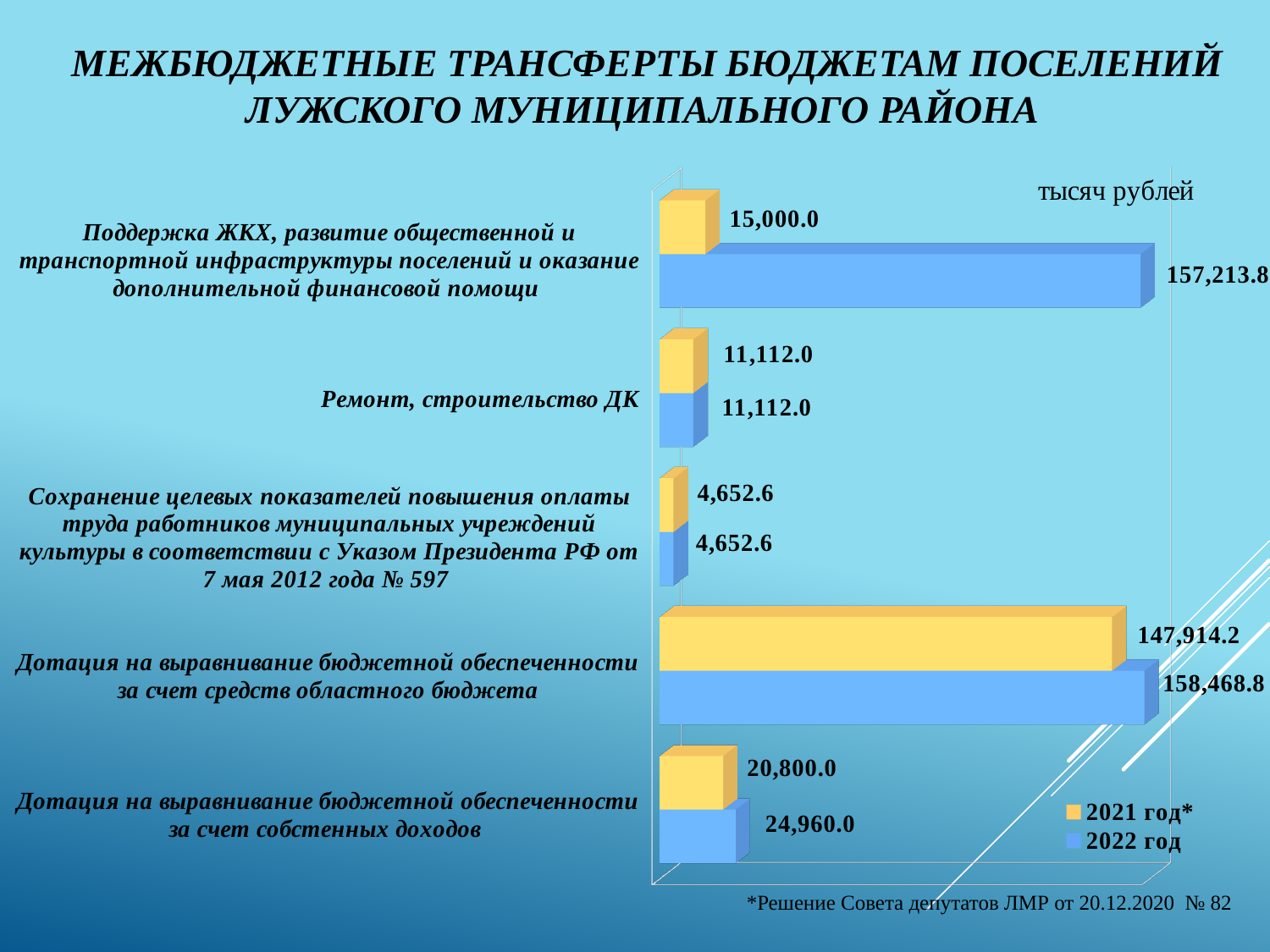
Which category has the highest 2022 год value? Дотация на выравнивание бюджетной обеспеченности за счет средств областного бюджета How many series does the legend list? 2 How many categories are shown in the chart? 5 What type of chart is shown on the slide? Bar chart What is the 2021 год* value for «Дотация на выравнивание бюджетной обеспеченности за счет средств областного бюджета»? 147,914.2 What is the 2022 год value for «Поддержка ЖКХ, развитие общественной и транспортной инфраструктуры поселений и оказание дополнительной финансовой помощи»? 157,213.8 What is the difference between the 2022 год and 2021 год* values for «Дотация на выравнивание бюджетной обеспеченности за счет средств областного бюджета»? 10,554.6 Which category has the lowest 2021 год* value? Сохранение целевых показателей повышения оплаты труда работников муниципальных учреждений культуры в соответствии с Указом Президента РФ от 7 мая 2012 года № 597 What is the difference between the 2022 год and 2021 год* values for «Дотация на выравнивание бюджетной обеспеченности за счет собственных доходов»? 4,160.0 What is the 2021 год* value for «Ремонт, строительство ДК»? 11,112.0 What is the 2022 год value for «Дотация на выравнивание бюджетной обеспеченности за счет собственных доходов»? 24,960.0 For «Поддержка ЖКХ, развитие общественной и транспортной инфраструктуры поселений и оказание дополнительной финансовой помощи», which year has the larger value, 2021 год* or 2022 год? 2022 год